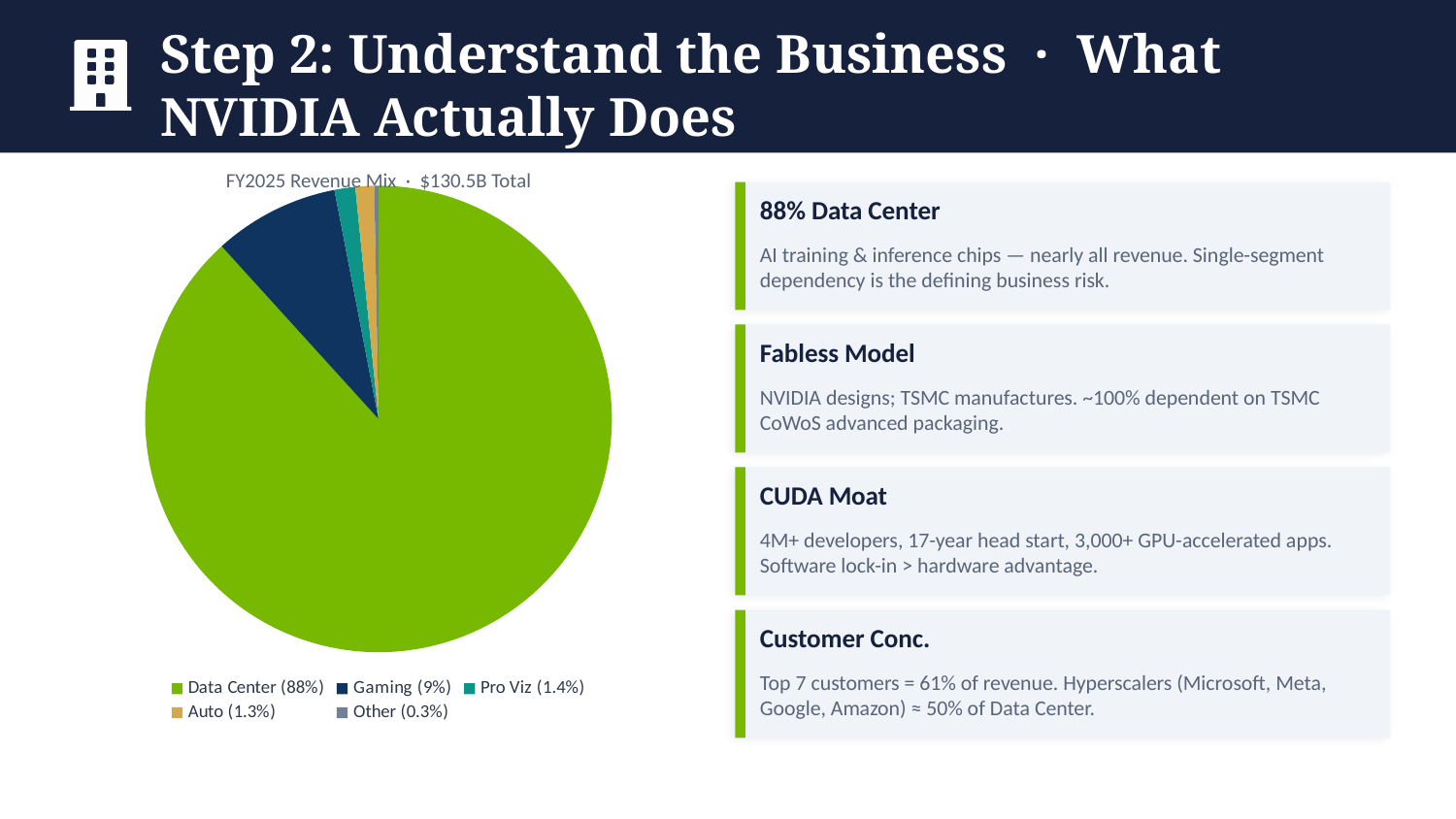
Which segment has the largest share of the pie? Data Center What share of revenue does the Pro Viz slice represent? 1.4% Which segment has the smallest share of the pie? Other What kind of chart is shown on the slide? Pie chart What share of revenue does the Auto slice represent? 1.3% How many slices does the pie chart have? 5 What share of revenue does the Data Center slice represent? 88% Which is larger, the Gaming share or the Pro Viz share? Gaming What is the difference in percentage points between the Data Center and Gaming shares? 79 percentage points What is the title of the pie chart? FY2025 Revenue Mix · $130.5B Total